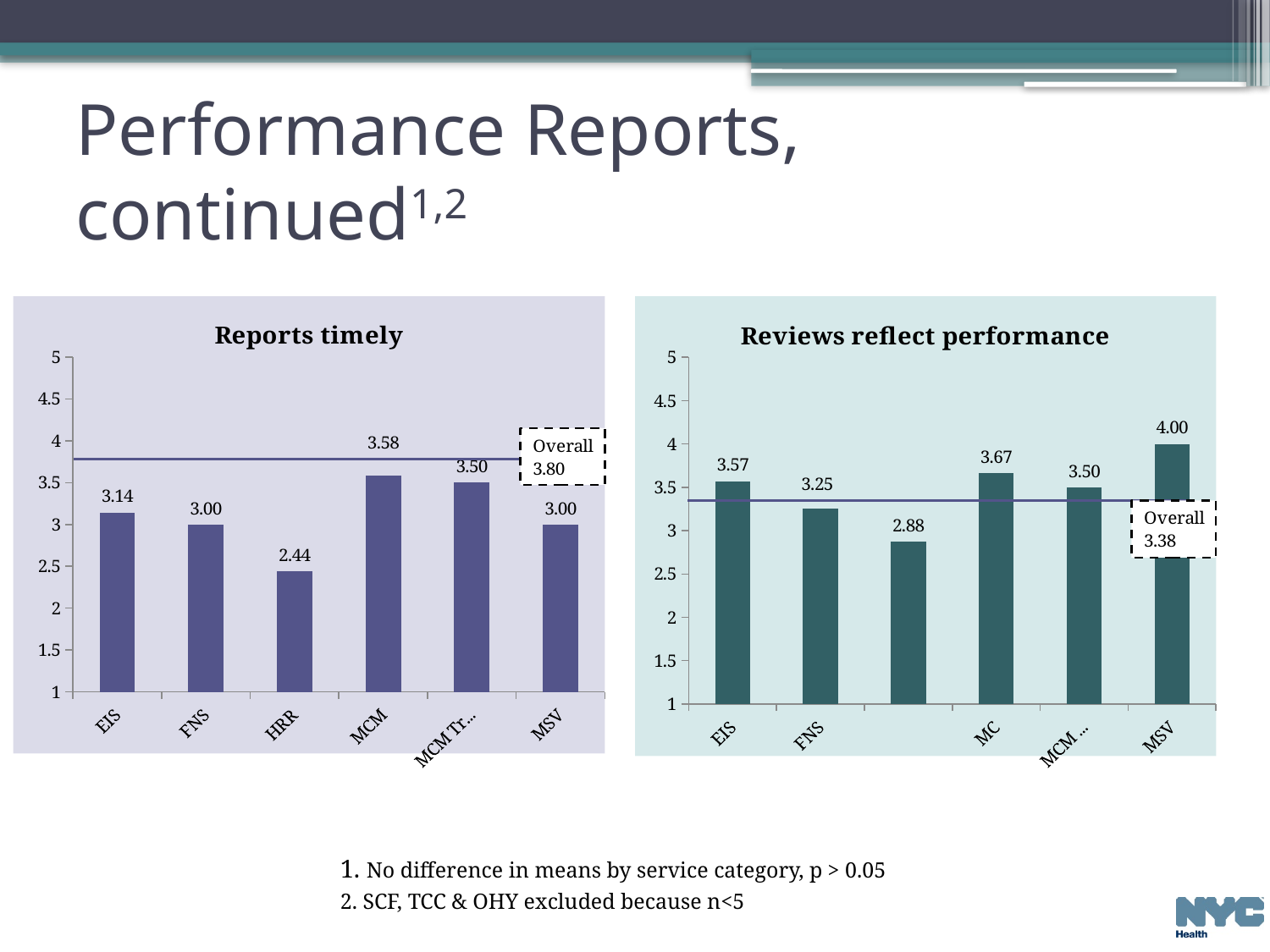
In the 'Reports timely' chart, which category has the lowest value? HRR In the 'Reports timely' chart, what is the value for HRR? 2.44 What type of chart is the 'Reports timely' chart? Bar chart In the 'Reviews reflect performance' chart, which category has the highest value? MSV In the 'Reviews reflect performance' chart, what is the value for FNS? 3.25 In the 'Reports timely' chart, what is the value for MCM? 3.58 In the 'Reports timely' chart, what is the difference between the values for MCM and HRR? 1.14 In the 'Reviews reflect performance' chart, what is the value for MSV? 4.00 How many bars are plotted in the 'Reviews reflect performance' chart? 6 In the 'Reports timely' chart, what is the overall value shown in the dashed box? 3.80 In the 'Reviews reflect performance' chart, which is larger, the value for EIS or the value for MC? MC In the 'Reports timely' chart, which category has the highest value? MCM